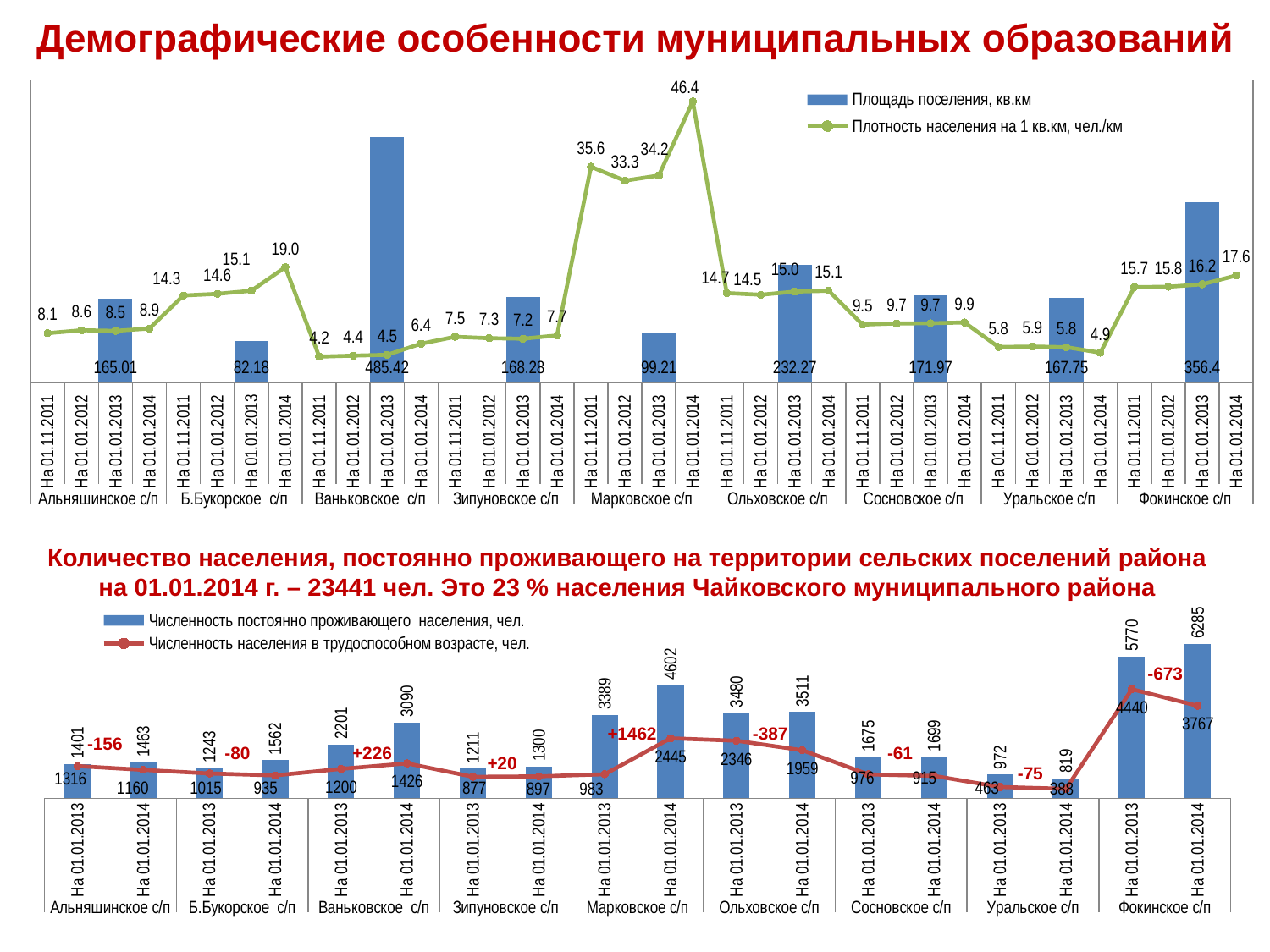
On the top chart, what is the area (Площадь поселения) of Ваньковское с/п in sq. km? 485.42 On the bottom chart, what is the difference between the working-age population of Фокинское с/п on 01.01.2013 (4440) and on 01.01.2014 (3767)? 673 On the bottom chart, which settlement has the lowest permanent population on 01.01.2014? Уральское с/п On the top chart, how many series does the legend list? 2 On the bottom chart, what is the working-age population of Марковское с/п on 01.01.2014? 2445 On the bottom chart, how many settlements (с/п) are shown along the x axis? 9 On the top chart, which settlement has the largest area bar? Ваньковское с/п On the top chart, what is the area of Фокинское с/п in sq. km? 356.4 On the top chart, what is the population density for Марковское с/п on 01.01.2014? 46.4 On the bottom chart, which is larger: the permanent population of Ольховское с/п on 01.01.2013 or on 01.01.2014? 01.01.2014 (3511) On the top chart, what is the lowest population density value shown? 4.2 On the bottom chart, what is the permanent population of Фокинское с/п on 01.01.2014? 6285